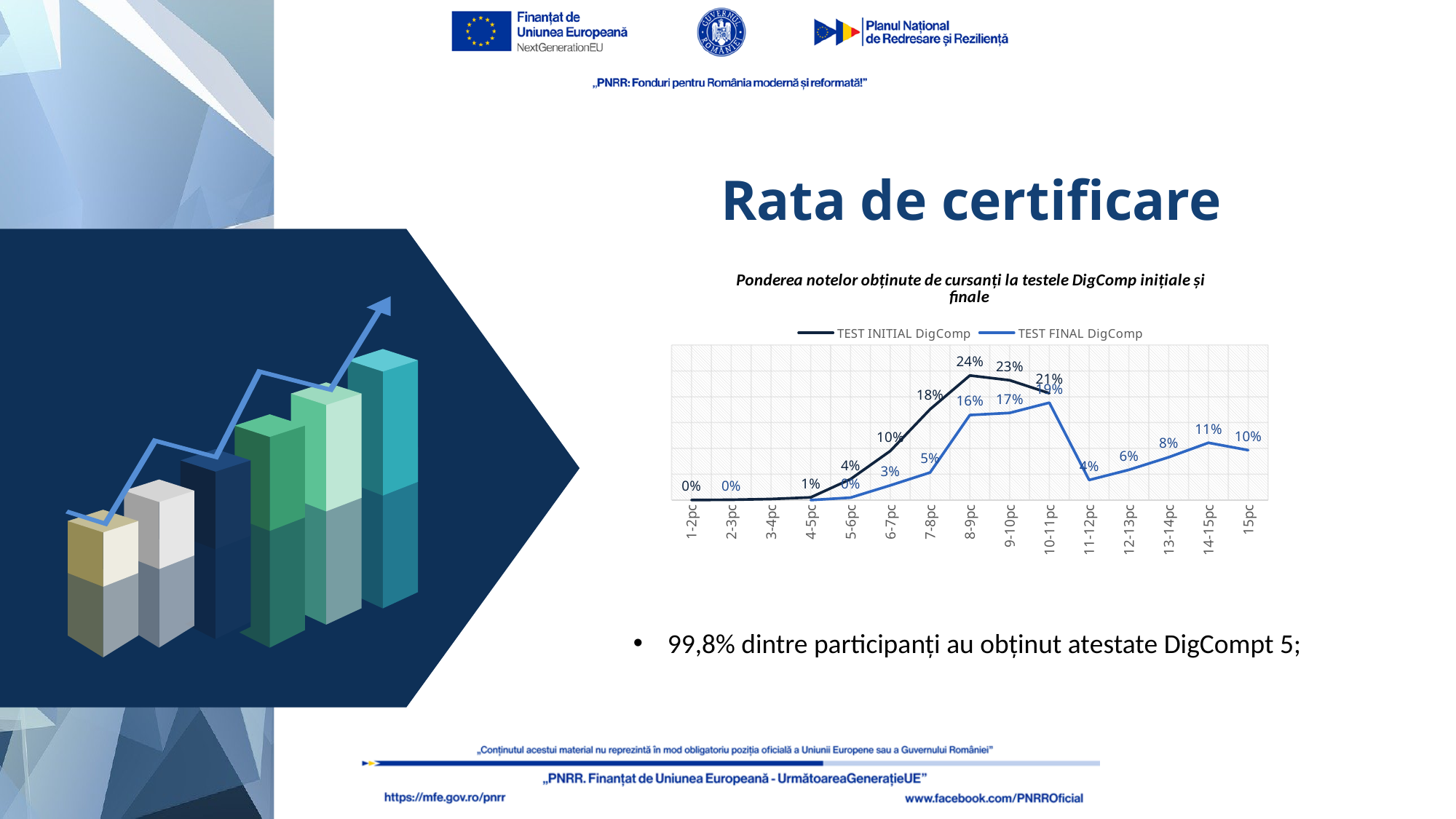
How many score categories are shown on the x axis of the chart? 15 What is the value of TEST INITIAL DigComp for the 8-9pc category? 24% What kind of chart is shown on the slide? line chart How many series does the chart legend list? 2 Does the TEST FINAL DigComp line rise or fall from 11-12pc to 14-15pc? rise What is the value of TEST INITIAL DigComp for the 7-8pc category? 18% In the 9-10pc category, which series has the larger value, TEST INITIAL DigComp or TEST FINAL DigComp? TEST INITIAL DigComp Which category has the highest value for TEST INITIAL DigComp? 8-9pc What is the difference between TEST INITIAL DigComp and TEST FINAL DigComp in the 8-9pc category? 8% Which category has the highest value for TEST FINAL DigComp? 10-11pc What is the value of TEST FINAL DigComp for the 14-15pc category? 11% What is the value of TEST FINAL DigComp for the 15pc category? 10%